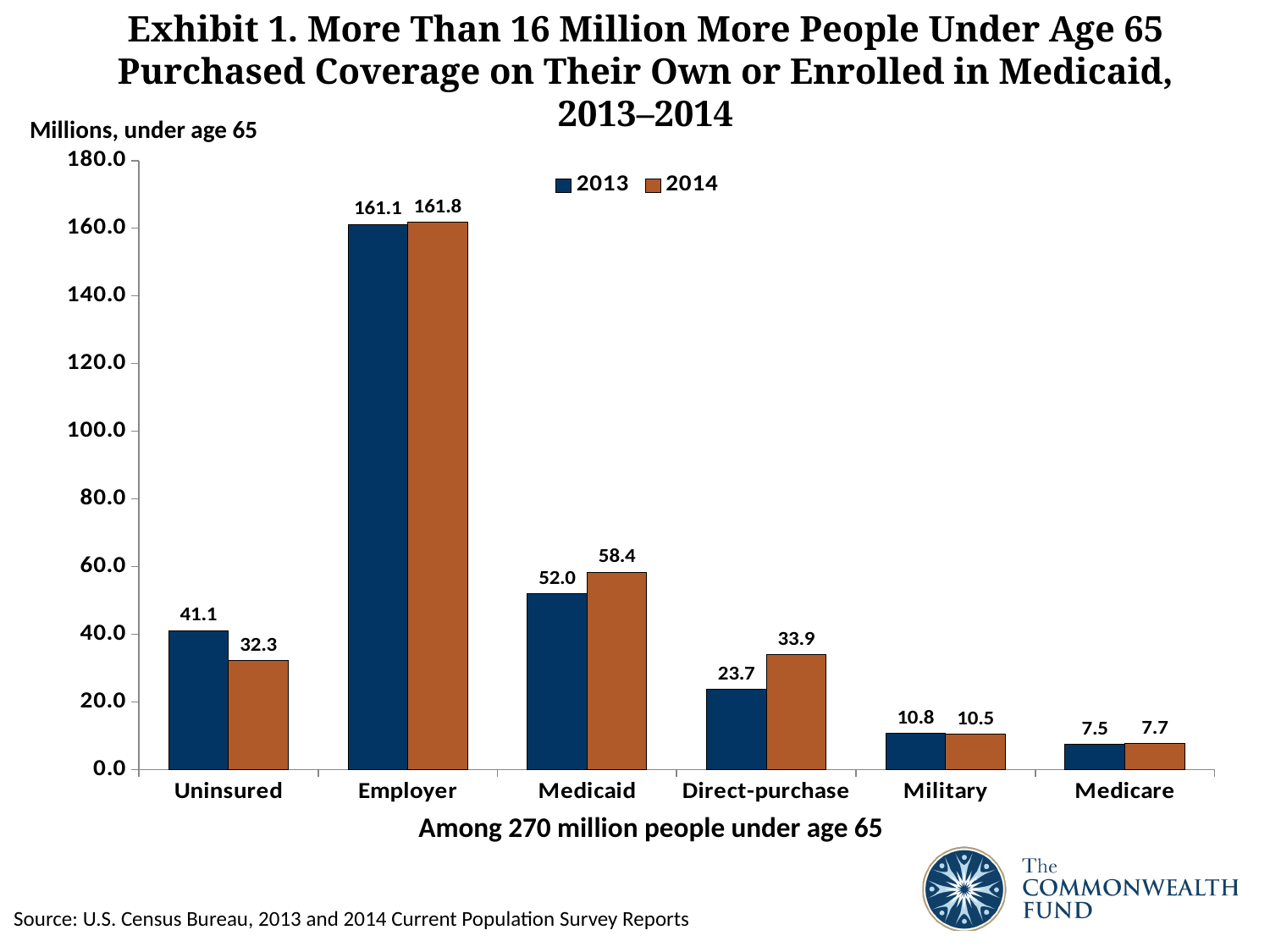
How many categories are shown on the x axis? 6 Which category has the highest 2014 value? Employer What is the 2014 value for Medicaid? 58.4 What is the difference between the 2014 and 2013 values for Medicaid? 6.4 How many series does the legend list? 2 What is the 2013 value for Uninsured? 41.1 What is the 2014 value for Direct-purchase? 33.9 What is the y-axis label of the chart? Millions, under age 65 Which category has the lowest 2013 value? Medicare What is the difference between the 2013 and 2014 values for Uninsured? 8.8 Which is larger for Direct-purchase, the 2013 value or the 2014 value? 2014 What kind of chart is shown on the slide? Bar chart